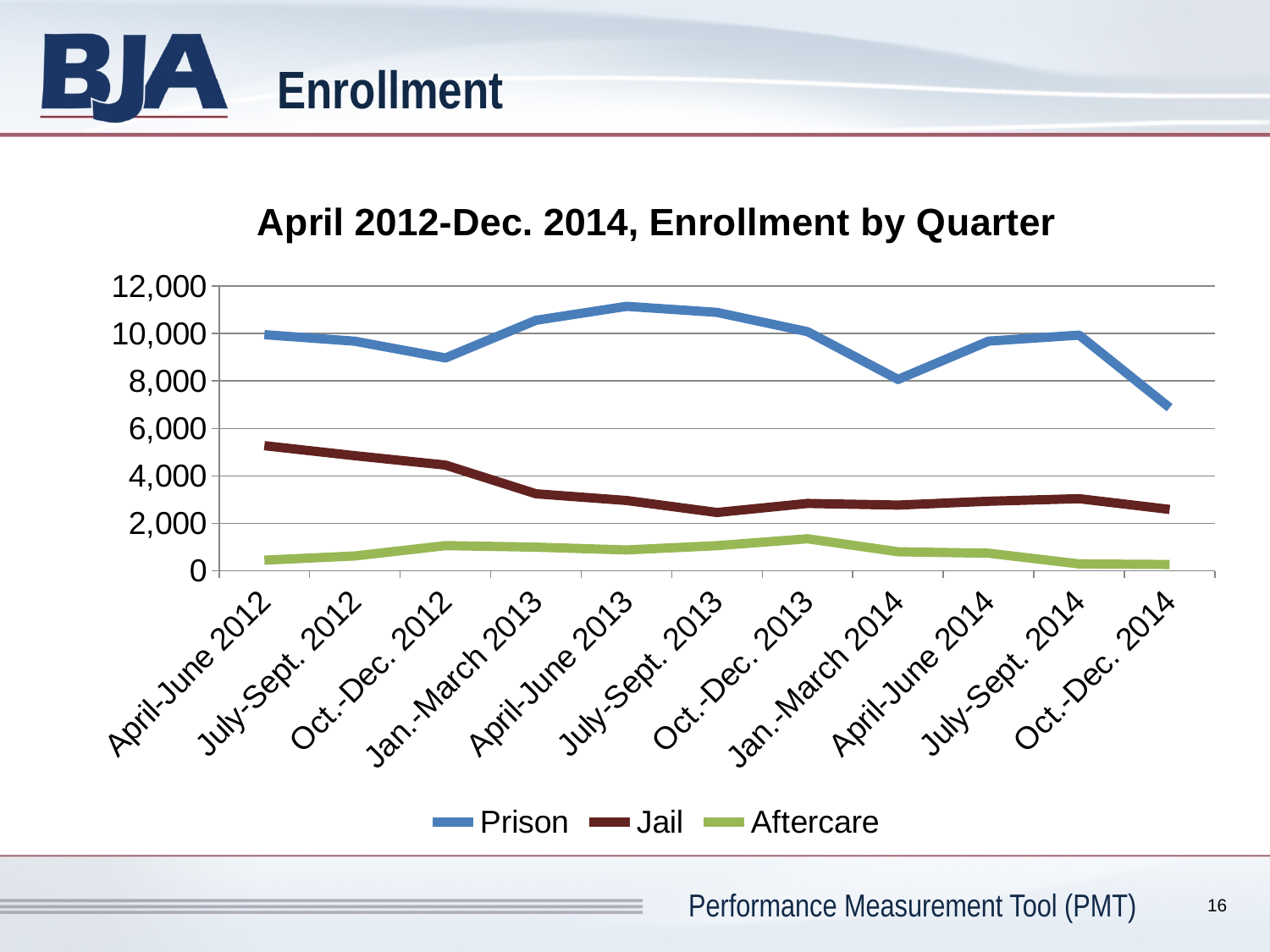
In which quarter is Jail enrollment highest? April-June 2012 Is the Prison value for April-June 2013 greater or less than 10,000? greater What kind of chart is shown on the slide? Line chart In which quarter is Prison enrollment lowest? Oct.-Dec. 2014 Which series has the larger value in Oct.-Dec. 2013, Jail or Aftercare? Jail What is the title of the chart? April 2012-Dec. 2014, Enrollment by Quarter Is the Jail value for April-June 2012 greater or less than 4,000? greater How many quarters are plotted along the x axis? 11 In which quarter is Prison enrollment highest? April-June 2013 Is the Prison value for Oct.-Dec. 2014 greater or less than 8,000? less Which series is shown by the green line? Aftercare How many series does the legend list? 3